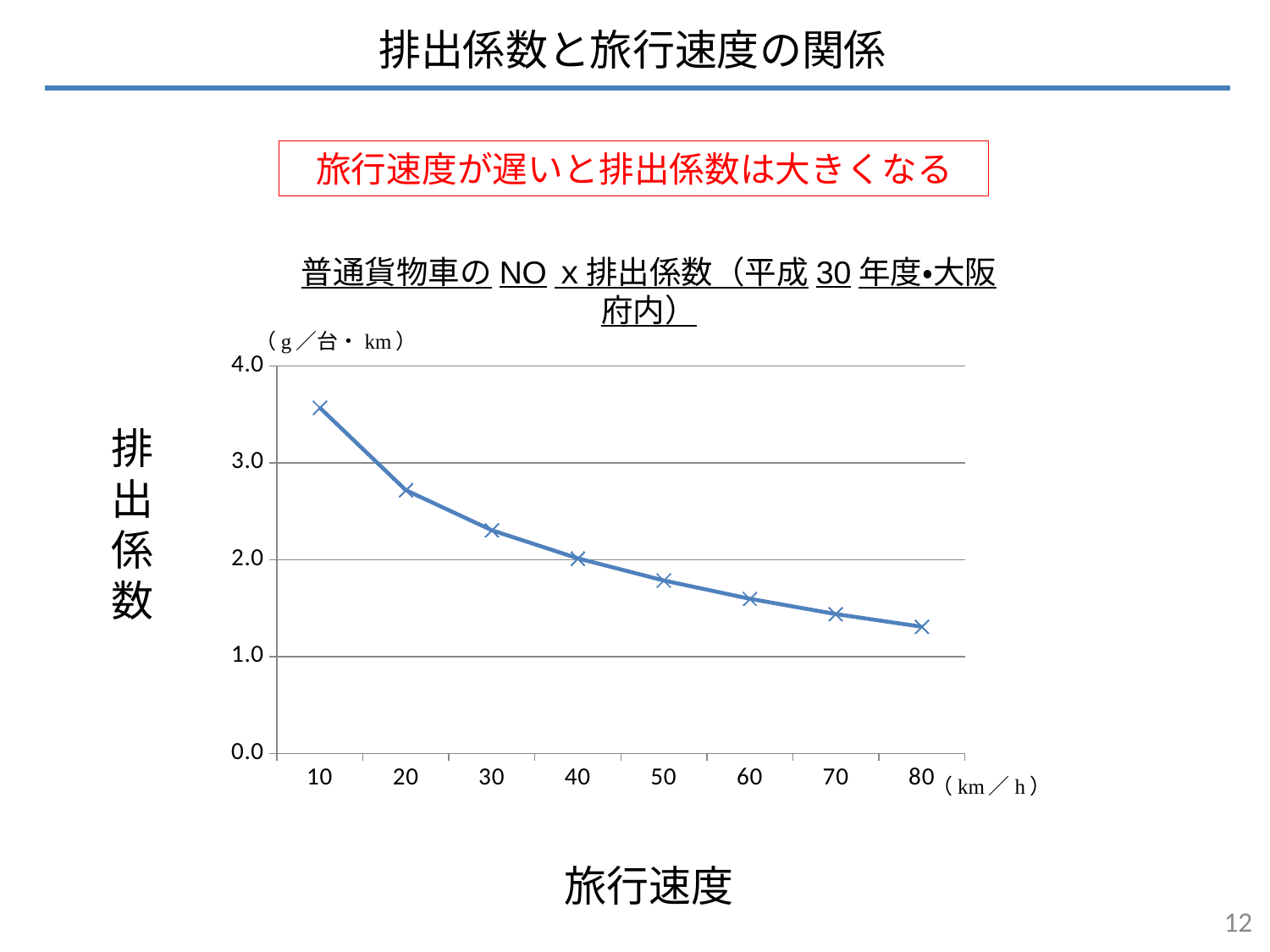
Is the emission factor at 80 km/h greater or less than 1.0? greater Is the emission factor at 10 km/h greater or less than 3.0? greater Is the emission factor at 20 km/h greater or less than 3.0? less What unit is shown for the y axis of the chart? g／台・km At which travel speed is the NOx emission factor lowest? 80 km/h What kind of chart is shown on the slide? line chart Do the emission factor values rise or fall as travel speed increases along the x axis? fall How many data points are plotted on the line? 8 At which travel speed is the NOx emission factor highest? 10 km/h Which has the larger emission factor, 20 km/h or 60 km/h? 20 km/h